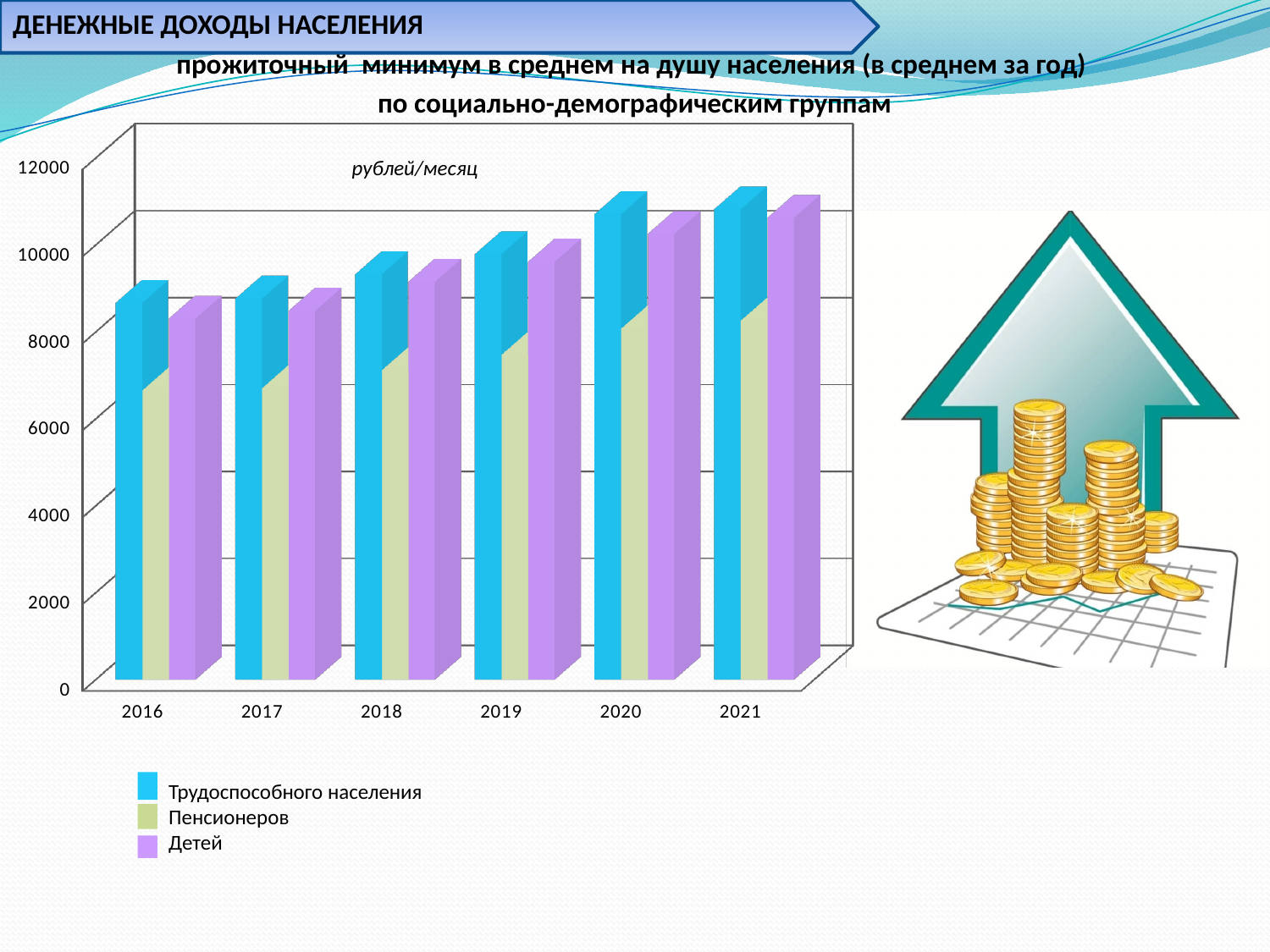
Which series is shown in blue in the chart? Трудоспособного населения Do the values for Детей rise or fall from 2016 to 2021? rise Is the value for Пенсионеров in 2021 greater or less than 8000? greater Which is larger in 2019: the value for Трудоспособного населения or for Пенсионеров? Трудоспособного населения Is the value for Трудоспособного населения in 2016 greater or less than 8000? greater What unit is indicated on the chart? рублей/месяц Is the value for Пенсионеров in 2016 greater or less than 8000? less What kind of chart is shown on the slide? bar chart How many series does the chart legend list? 3 How many years are shown on the x axis of the chart? 6